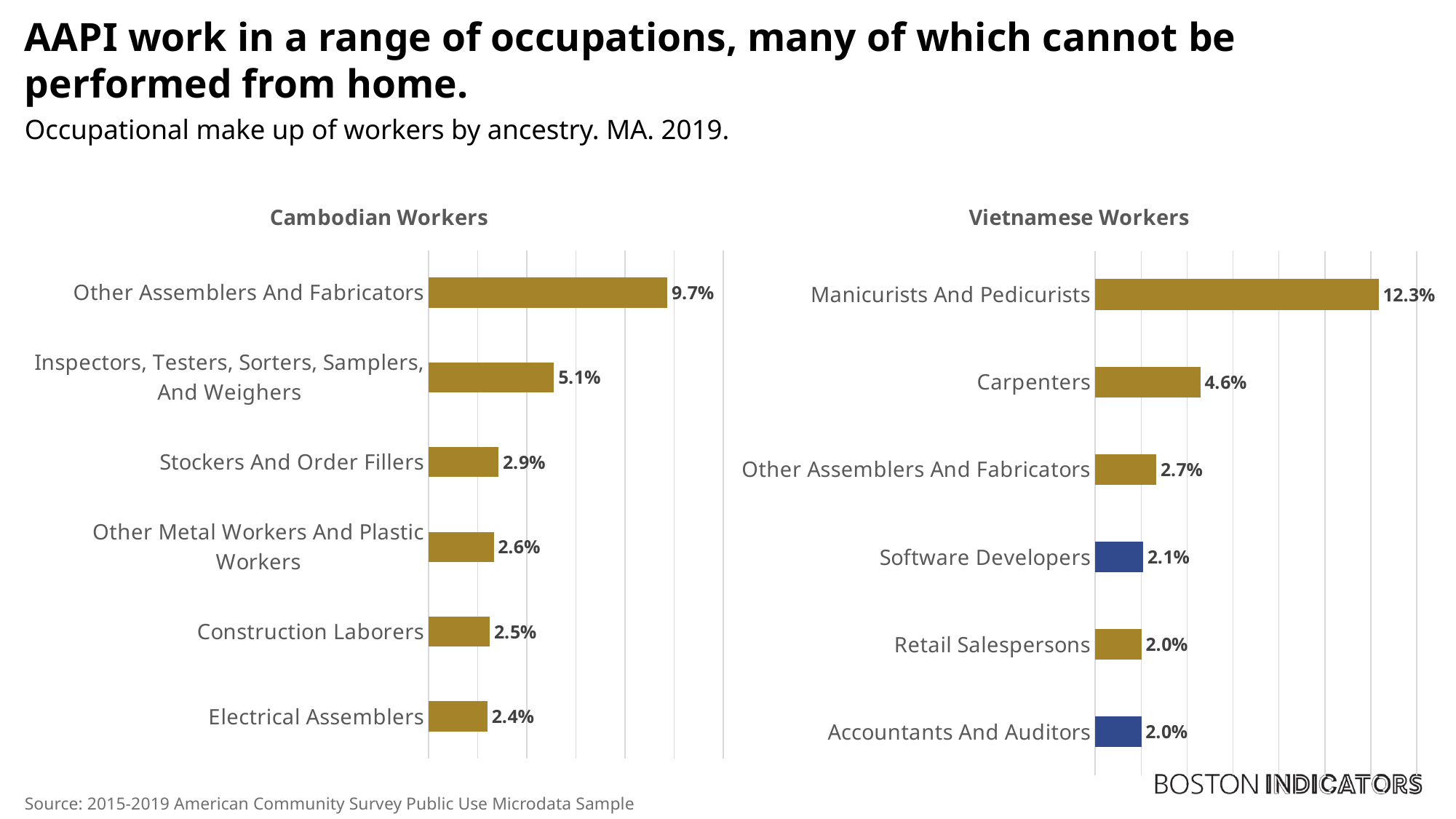
How many occupations are shown in the Cambodian Workers chart? 6 In the Vietnamese Workers chart, which occupation has the highest value? Manicurists And Pedicurists In the Vietnamese Workers chart, what is the difference between Manicurists And Pedicurists and Carpenters? 7.7% How many occupations are shown in the Vietnamese Workers chart? 6 In the Cambodian Workers chart, what is the value for Other Assemblers And Fabricators? 9.7% In the Vietnamese Workers chart, what is the value for Carpenters? 4.6% What type of chart is the Cambodian Workers chart? Bar chart In the Cambodian Workers chart, which occupation has the lowest value? Electrical Assemblers In the Vietnamese Workers chart, which occupations are shown with blue bars? Software Developers and Accountants And Auditors Which is larger: Other Assemblers And Fabricators in the Cambodian Workers chart or Other Assemblers And Fabricators in the Vietnamese Workers chart? Cambodian Workers In the Cambodian Workers chart, which is larger: Stockers And Order Fillers or Construction Laborers? Stockers And Order Fillers In the Cambodian Workers chart, what is the difference between Other Assemblers And Fabricators and Inspectors, Testers, Sorters, Samplers, And Weighers? 4.6%